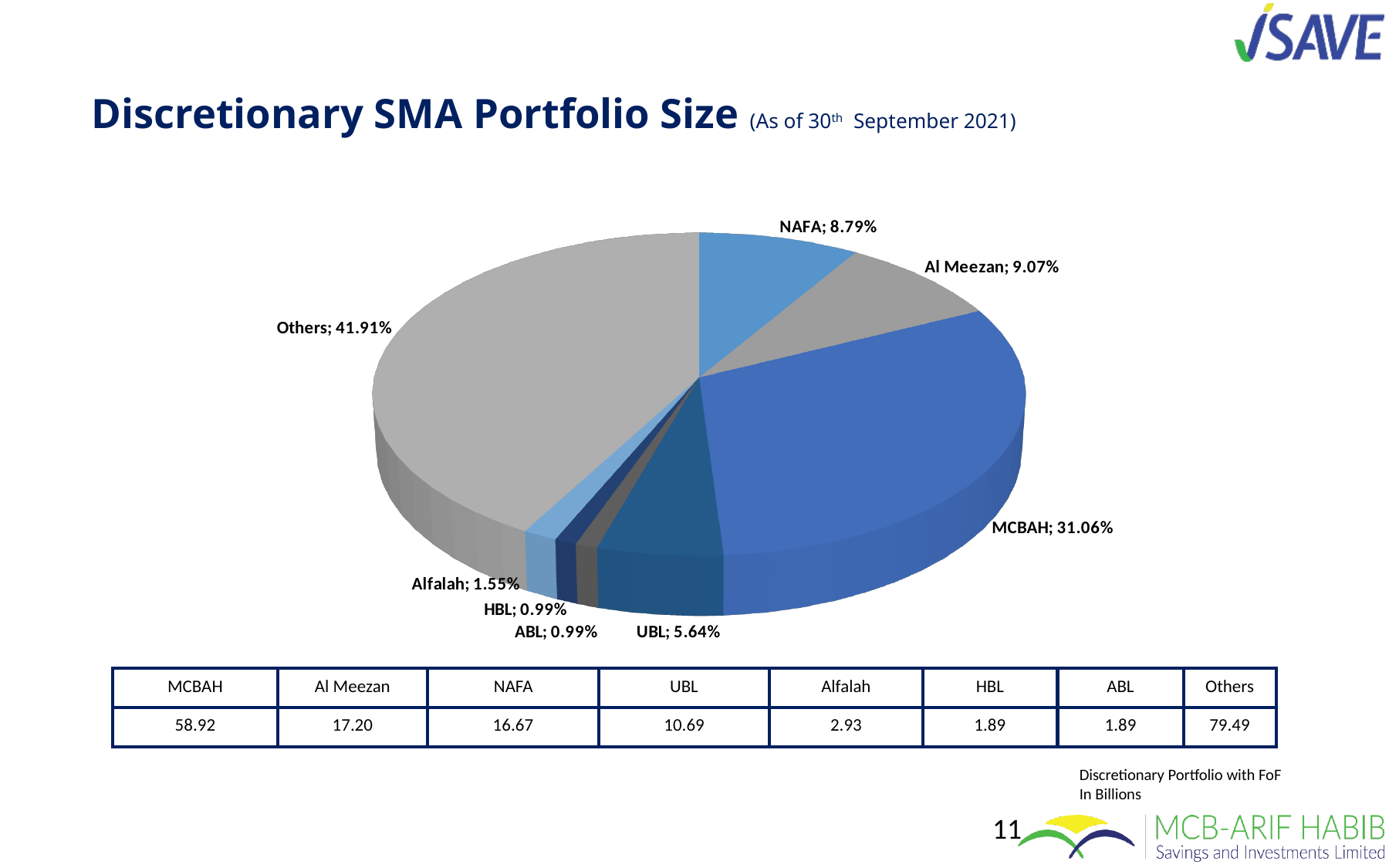
What share of the pie does Others hold? 41.91% What percentage is shown for NAFA? 8.79% What is the title of the chart on the slide? Discretionary SMA Portfolio Size How many slices does the pie chart have? 8 Which is larger, the share for Al Meezan or the share for NAFA? Al Meezan What kind of chart is shown on the slide? Pie chart What percentage is shown for Al Meezan? 9.07% What is the difference in percentage points between Others and MCBAH? 10.85 Which slice of the pie is the largest? Others What share of the pie does MCBAH hold? 31.06% What percentage is shown for UBL? 5.64% Which slice has the smallest share, Alfalah or UBL? Alfalah